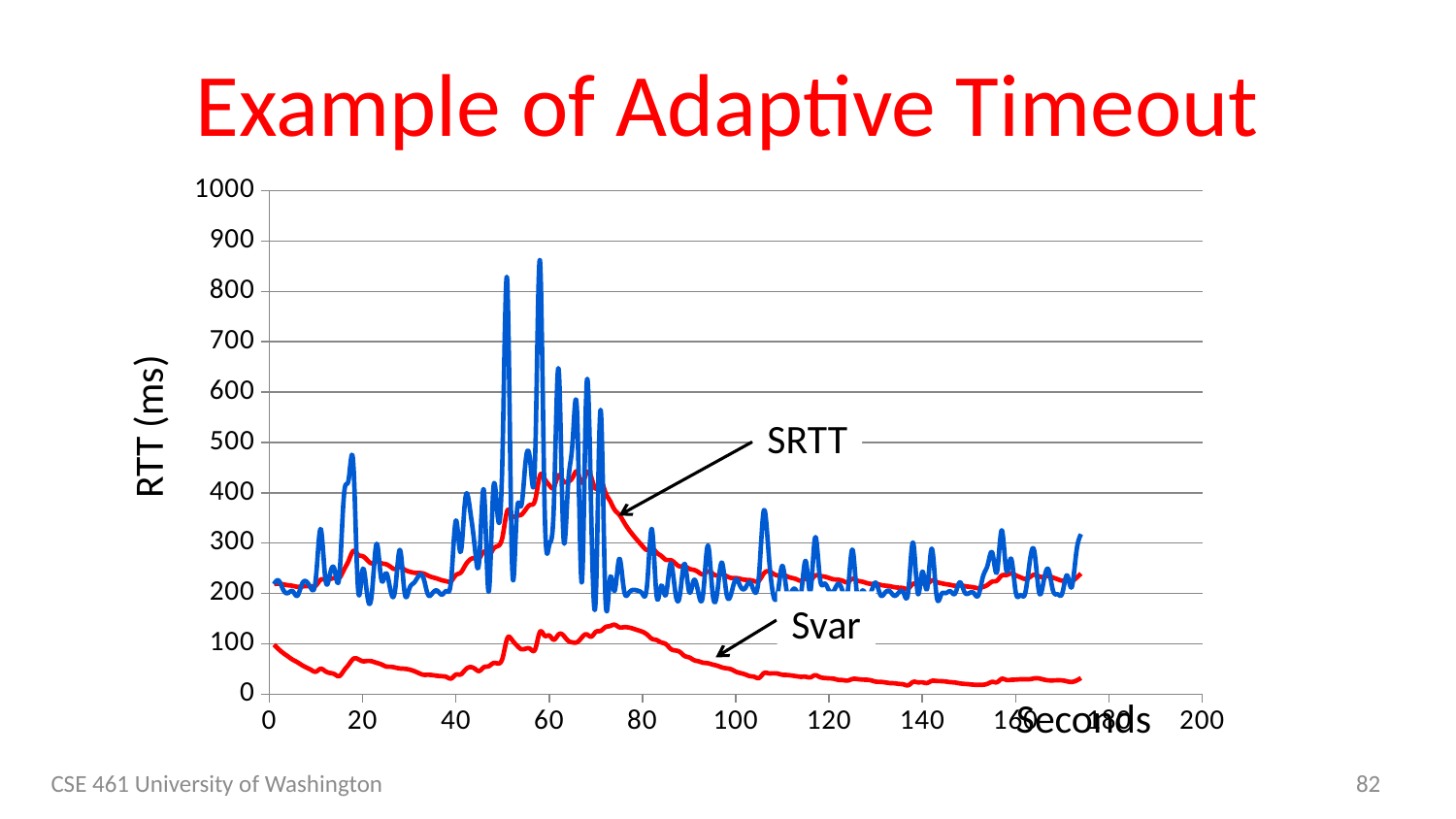
At 100 seconds, which line has the larger value, SRTT or Svar? SRTT Is the value of the SRTT line at 65 seconds greater or less than 400? greater Is the value of the Svar line at 100 seconds greater or less than 100? less Is the value of the Svar line at 20 seconds greater or less than 100? less What is the title of the chart on the slide? Example of Adaptive Timeout Does the SRTT line rise or fall between 40 and 60 seconds? rise What kind of chart is shown on the slide? line chart What is the label on the vertical axis of the chart? RTT (ms) Does the Svar line rise or fall between 80 and 140 seconds? fall